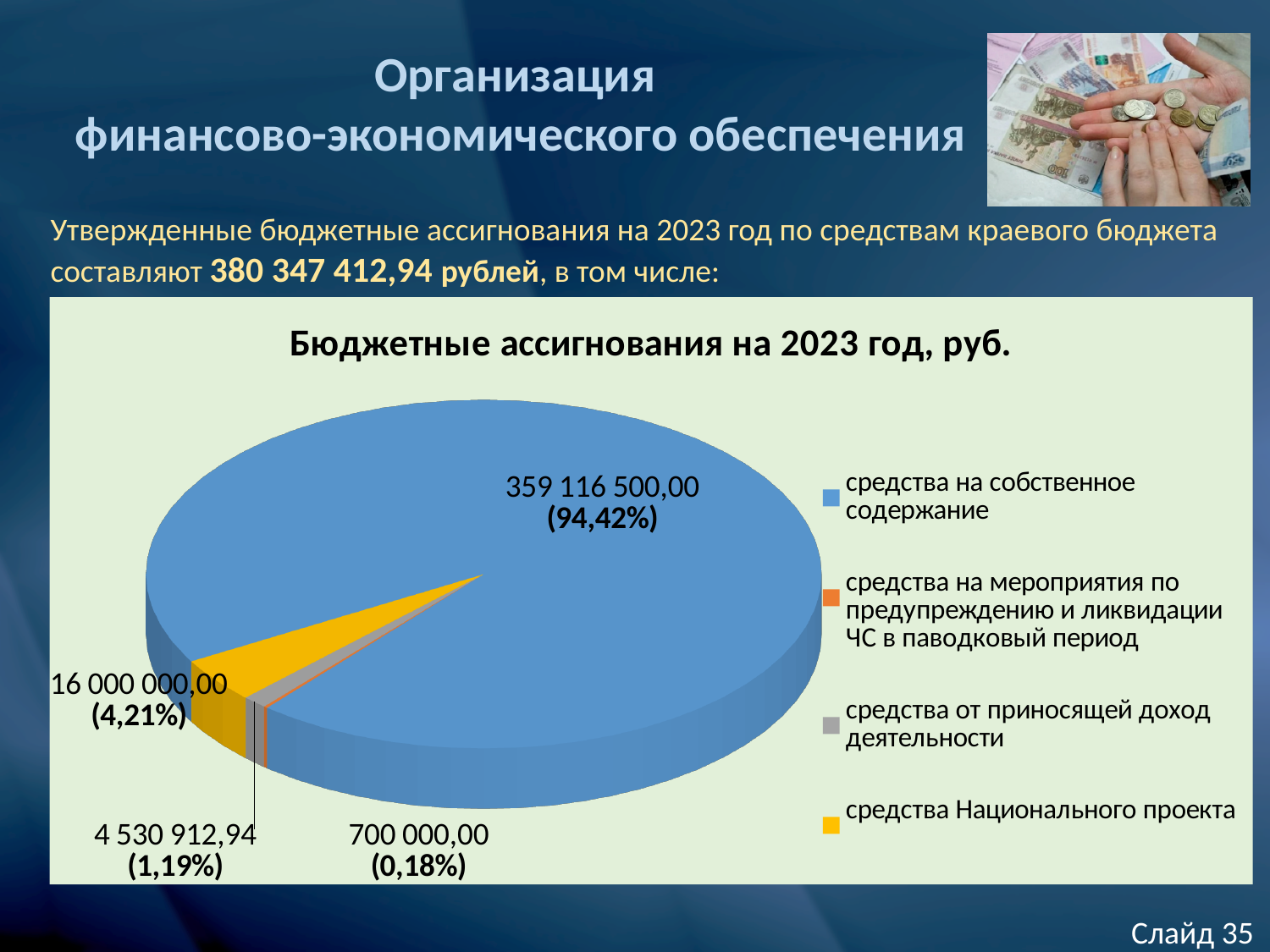
What is the value for средства на собственное содержание? 359 116 500,00 What is the value for средства на мероприятия по предупреждению и ликвидации ЧС в паводковый период? 700 000,00 What share of the pie is средства от приносящей доход деятельности? 1,19% What share of the pie is средства Национального проекта? 4,21% Which category has the smallest slice? средства на мероприятия по предупреждению и ликвидации ЧС в паводковый период What is the difference between the value for средства Национального проекта and the value for средства от приносящей доход деятельности? 11 469 087,06 How many slices does the pie chart have? 4 What is the value for средства от приносящей доход деятельности? 4 530 912,94 Which category has the largest slice? средства на собственное содержание What is the title of the chart? Бюджетные ассигнования на 2023 год, руб. What is the value for средства Национального проекта? 16 000 000,00 What type of chart is shown on the slide? Pie chart